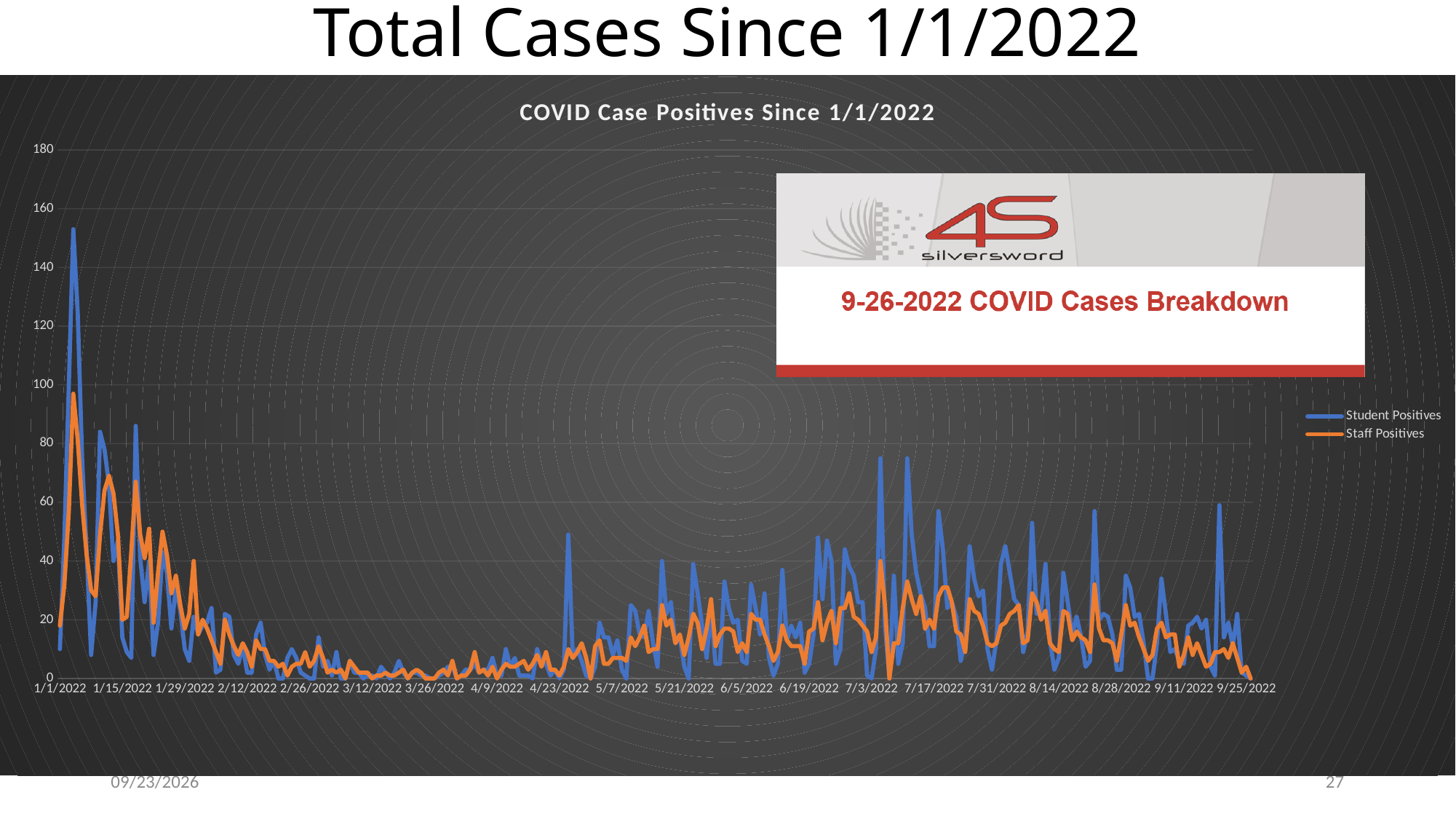
What is the highest value shown on the vertical axis? 180 Which series reaches the highest peak on the chart, Student Positives or Staff Positives? Student Positives Is the Staff Positives value around 3/26/2022 greater or less than 20? less Is the highest value of the Student Positives series greater or less than 140? greater Which series is drawn in orange? Staff Positives How many series does the chart's legend list? 2 What is the title of the chart? COVID Case Positives Since 1/1/2022 Is the highest value of the Staff Positives series greater or less than 100? less What kind of chart is shown on the slide? line chart In which month does the Student Positives series reach its highest value? January 2022 Do the Student Positives values rise or fall between early January 2022 and mid-March 2022? fall